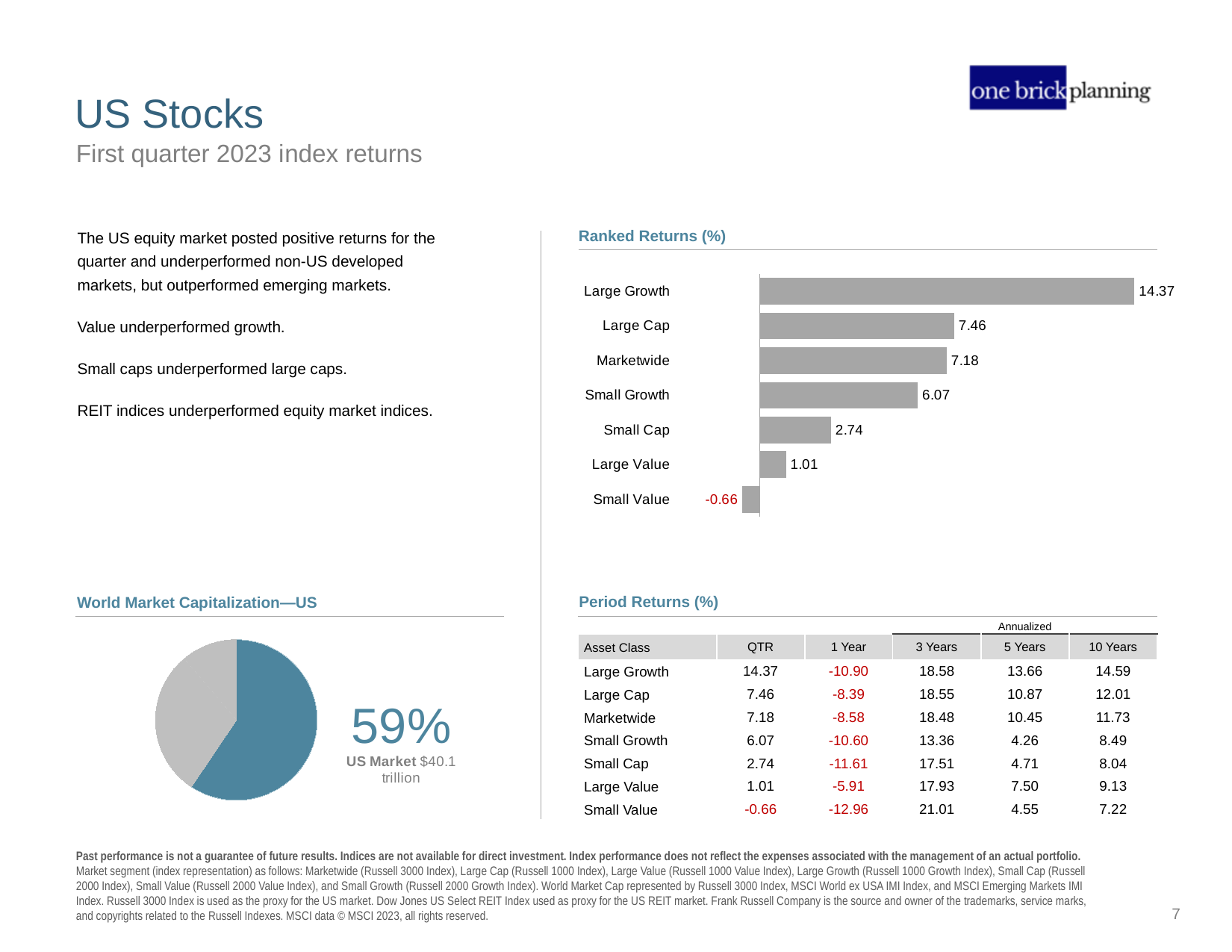
In the Ranked Returns (%) chart, what is the difference between Large Cap and Marketwide? 0.28 In the Ranked Returns (%) chart, what is the value for Small Value? -0.66 In the Ranked Returns (%) chart, what is the value for Large Growth? 14.37 In the Ranked Returns (%) chart, which category has the lowest value? Small Value In the World Market Capitalization—US chart, what share of the pie does the US Market represent? 59% How many categories are shown in the Ranked Returns (%) chart? 7 In the Ranked Returns (%) chart, what is the value for Small Cap? 2.74 In the Ranked Returns (%) chart, what is the difference between Large Growth and Small Growth? 8.30 What kind of chart is the Ranked Returns (%) chart? Bar chart In the Ranked Returns (%) chart, which is larger, Small Growth or Small Cap? Small Growth What kind of chart is the World Market Capitalization—US chart? Pie chart In the Ranked Returns (%) chart, which category has the highest value? Large Growth